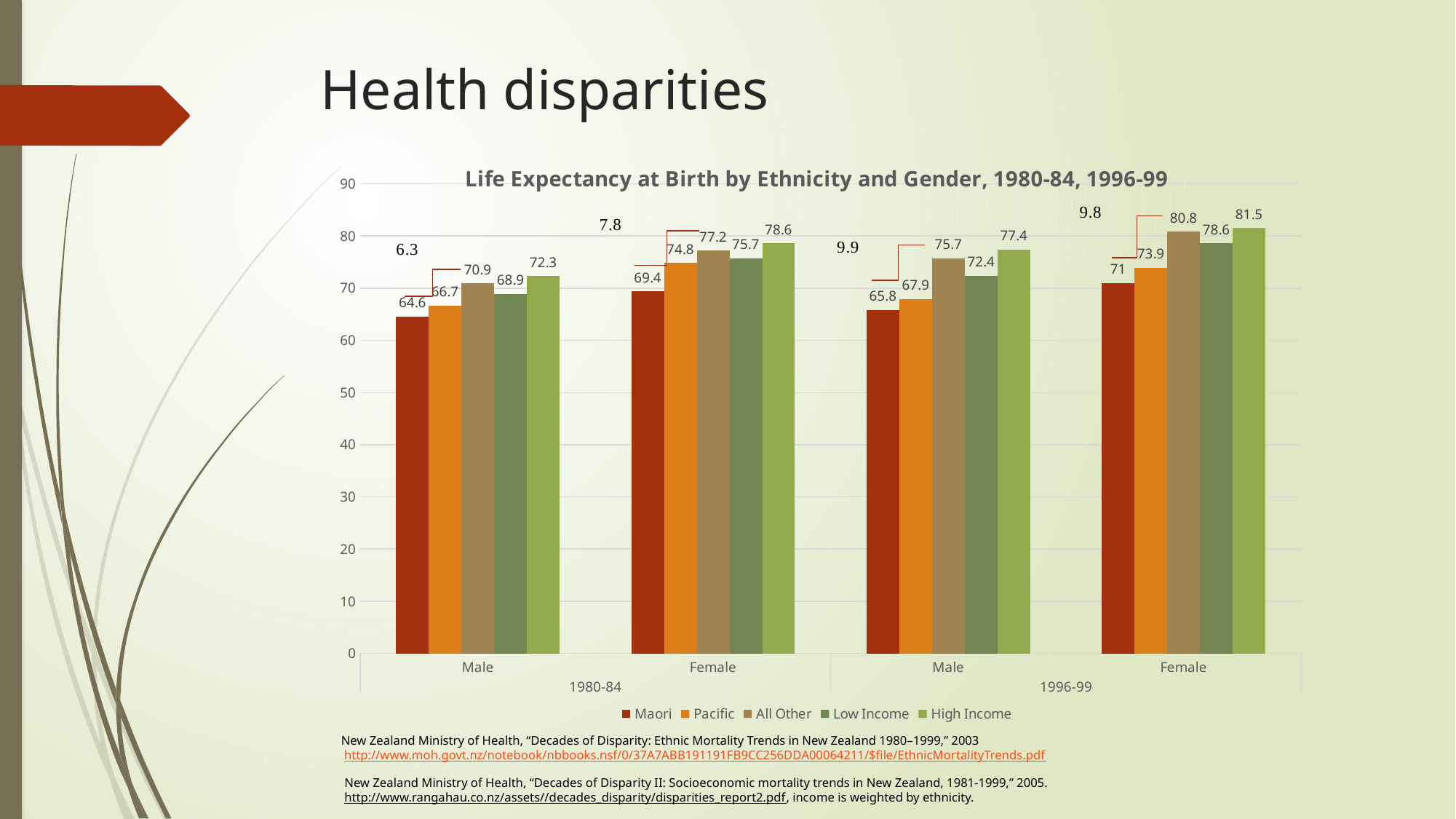
How many series does the legend list? 5 What is the life expectancy for Maori males in 1980-84? 64.6 What is the life expectancy for Low Income females in 1980-84? 75.7 Which is larger: the Pacific female life expectancy in 1980-84 or the Pacific female life expectancy in 1996-99? Pacific female 1980-84 (74.8) Which series has the lowest life expectancy for males in 1980-84? Maori What is the difference between the All Other and Maori life expectancy for males in 1996-99? 9.9 How many category groups are shown on the x axis? 4 What is the life expectancy for High Income females in 1996-99? 81.5 Which series has the highest life expectancy for females in 1996-99? High Income What is the title of the chart? Life Expectancy at Birth by Ethnicity and Gender, 1980-84, 1996-99 What is the life expectancy for All Other males in 1996-99? 75.7 What kind of chart is shown on the slide? Bar chart